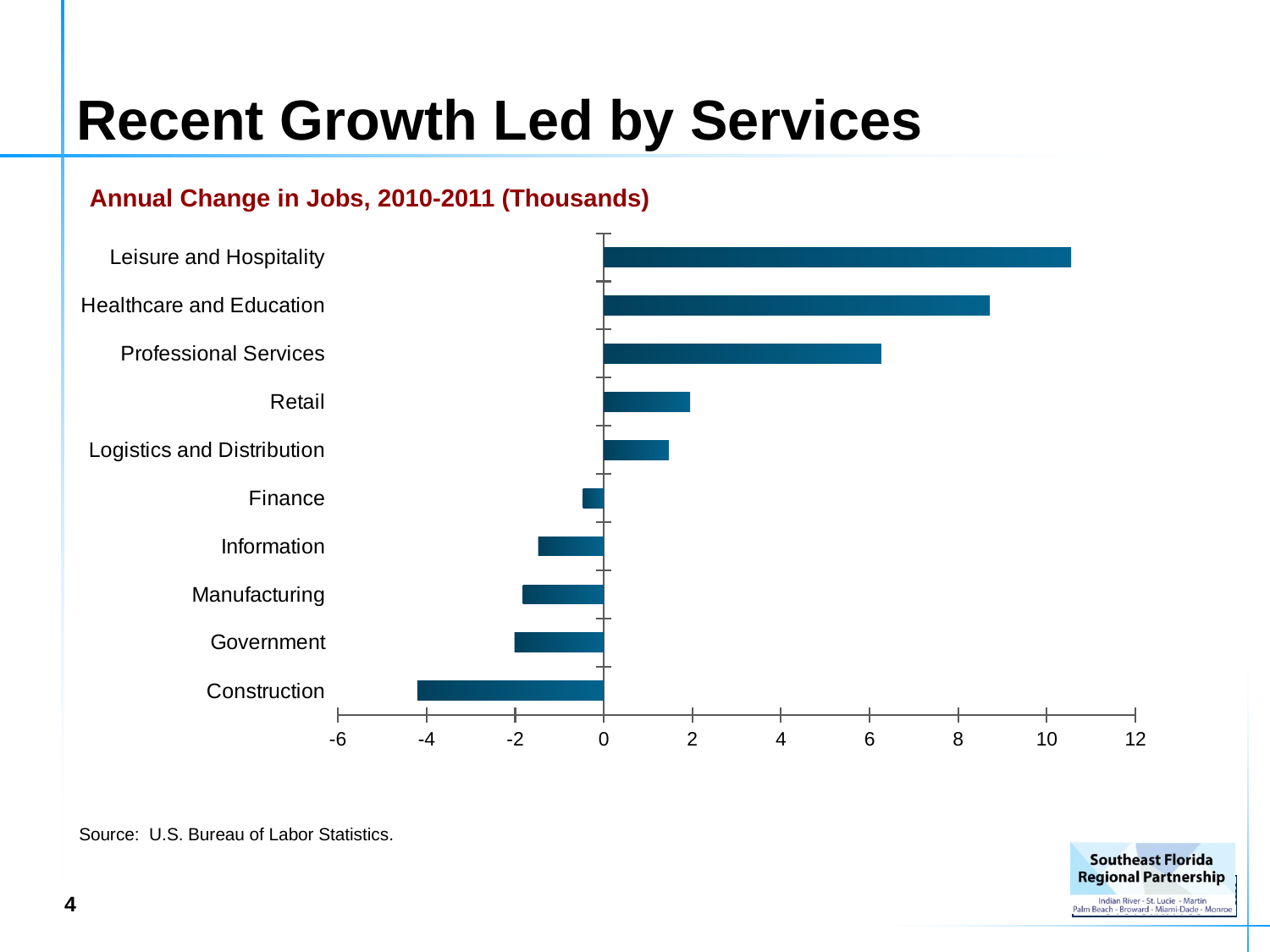
How many categories (sectors) are plotted in the chart? 10 How many sectors show a negative change in jobs? 5 Is the value for Logistics and Distribution greater or less than 2? less What source is cited for the chart data? U.S. Bureau of Labor Statistics Is the value for Leisure and Hospitality greater or less than 10? greater Which sector has the lowest annual change in jobs? Construction Which is larger, the value for Healthcare and Education or the value for Professional Services? Healthcare and Education What kind of chart is shown on the slide? Bar chart What is the title of the chart? Annual Change in Jobs, 2010-2011 (Thousands) Is the value for Healthcare and Education greater or less than 8? greater Which sector has the highest annual change in jobs? Leisure and Hospitality